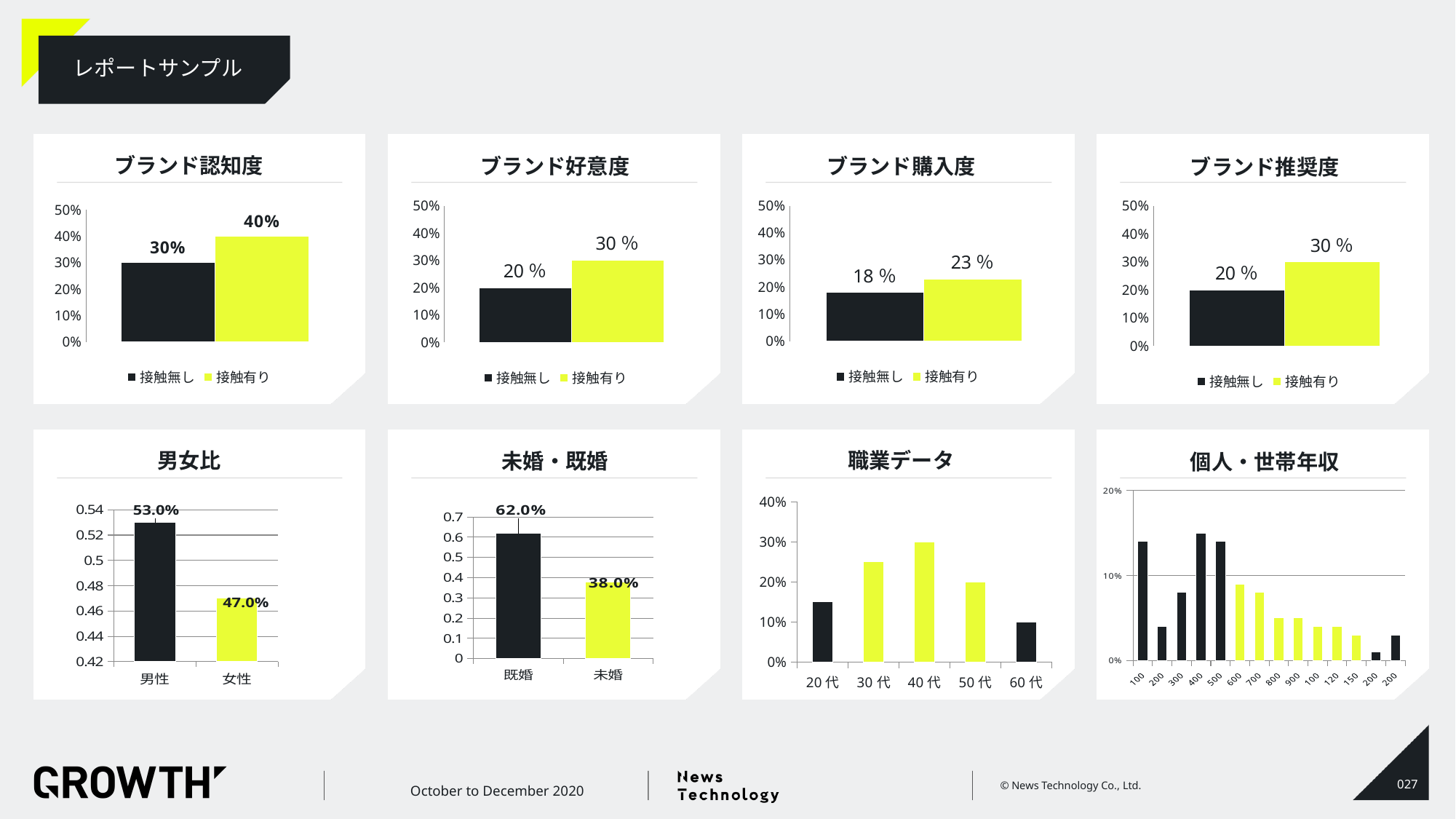
In the ブランド認知度 chart, what is the difference between 接触有り and 接触無し? 10% In the 男女比 chart, what is the value for 男性? 53.0% In the 未婚・既婚 chart, which category is highest? 既婚 In the ブランド購入度 chart, which series is larger, 接触無し or 接触有り? 接触有り In the ブランド推奨度 chart, what is the value for 接触有り? 30 % How many series does the legend of the ブランド推奨度 chart list? 2 In the ブランド購入度 chart, what is the value for 接触有り? 23 % In the ブランド好意度 chart, what is the value for 接触無し? 20 % In the ブランド認知度 chart, what is the value for 接触有り? 40% In the 職業データ chart, which category has the highest bar? 40 代 In the 職業データ chart, is the value for 60 代 greater or less than 20%? less In the 未婚・既婚 chart, what is the value for 未婚? 38.0%